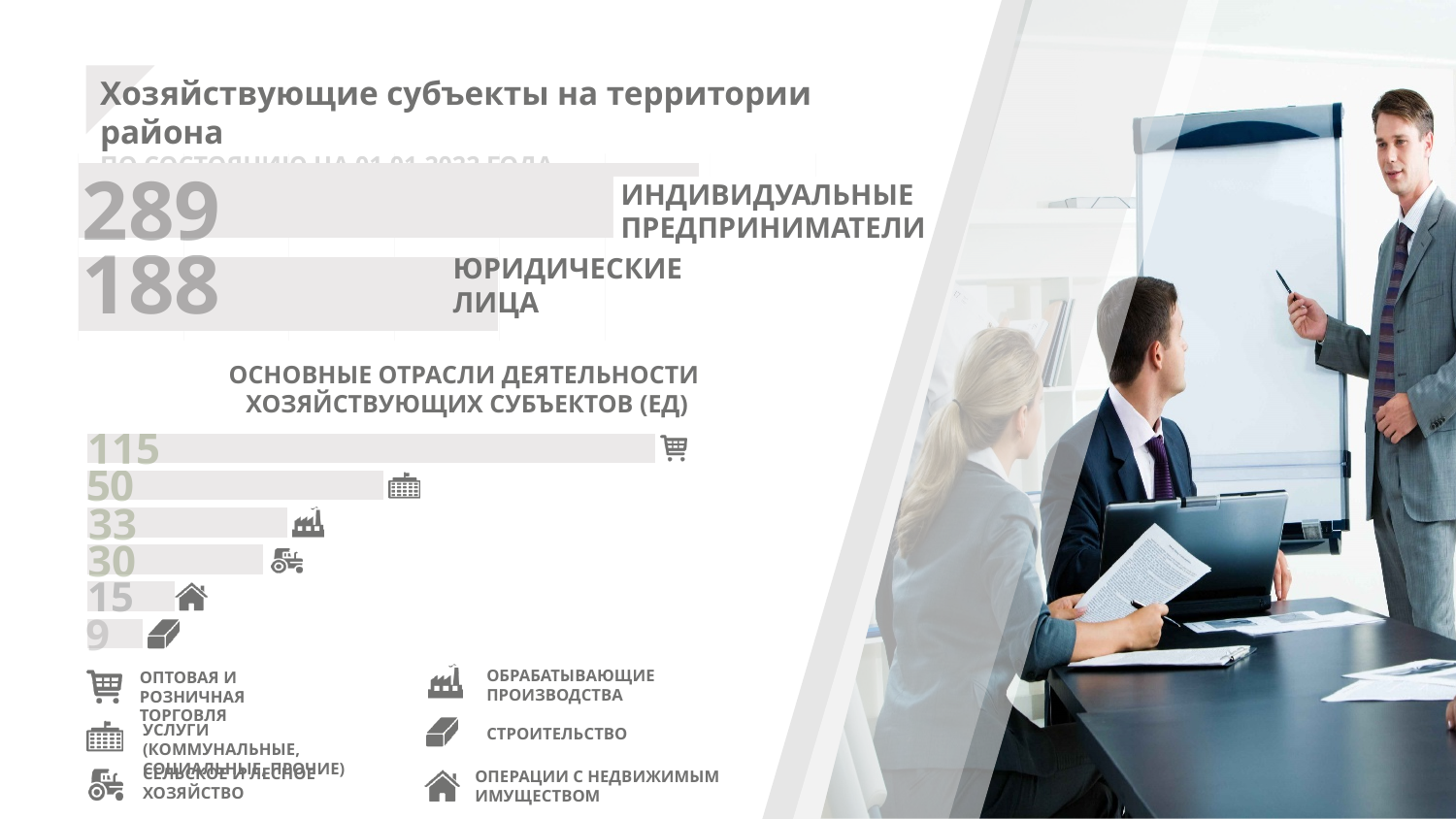
In the chart 'Основные отрасли деятельности хозяйствующих субъектов (ед)', what is the difference between услуги and обрабатывающие производства? 17 What kind of chart is 'Основные отрасли деятельности хозяйствующих субъектов (ед)'? Bar chart How many categories are shown in the chart 'Основные отрасли деятельности хозяйствующих субъектов (ед)'? 6 In the chart 'Основные отрасли деятельности хозяйствующих субъектов (ед)', what is the value for строительство? 9 In the top bars of the slide, what is the difference between индивидуальные предприниматели and юридические лица? 101 In the chart 'Основные отрасли деятельности хозяйствующих субъектов (ед)', what is the value for оптовая и розничная торговля? 115 In the chart 'Основные отрасли деятельности хозяйствующих субъектов (ед)', which is larger: обрабатывающие производства or сельское и лесное хозяйство? Обрабатывающие производства In the chart 'Основные отрасли деятельности хозяйствующих субъектов (ед)', which category has the highest value? Оптовая и розничная торговля In the top bars of the slide, what is the value for индивидуальные предприниматели? 289 In the chart 'Основные отрасли деятельности хозяйствующих субъектов (ед)', which category has the lowest value? Строительство In the chart 'Основные отрасли деятельности хозяйствующих субъектов (ед)', what is the value for сельское и лесное хозяйство? 30 In the chart 'Основные отрасли деятельности хозяйствующих субъектов (ед)', what is the value for операции с недвижимым имуществом? 15